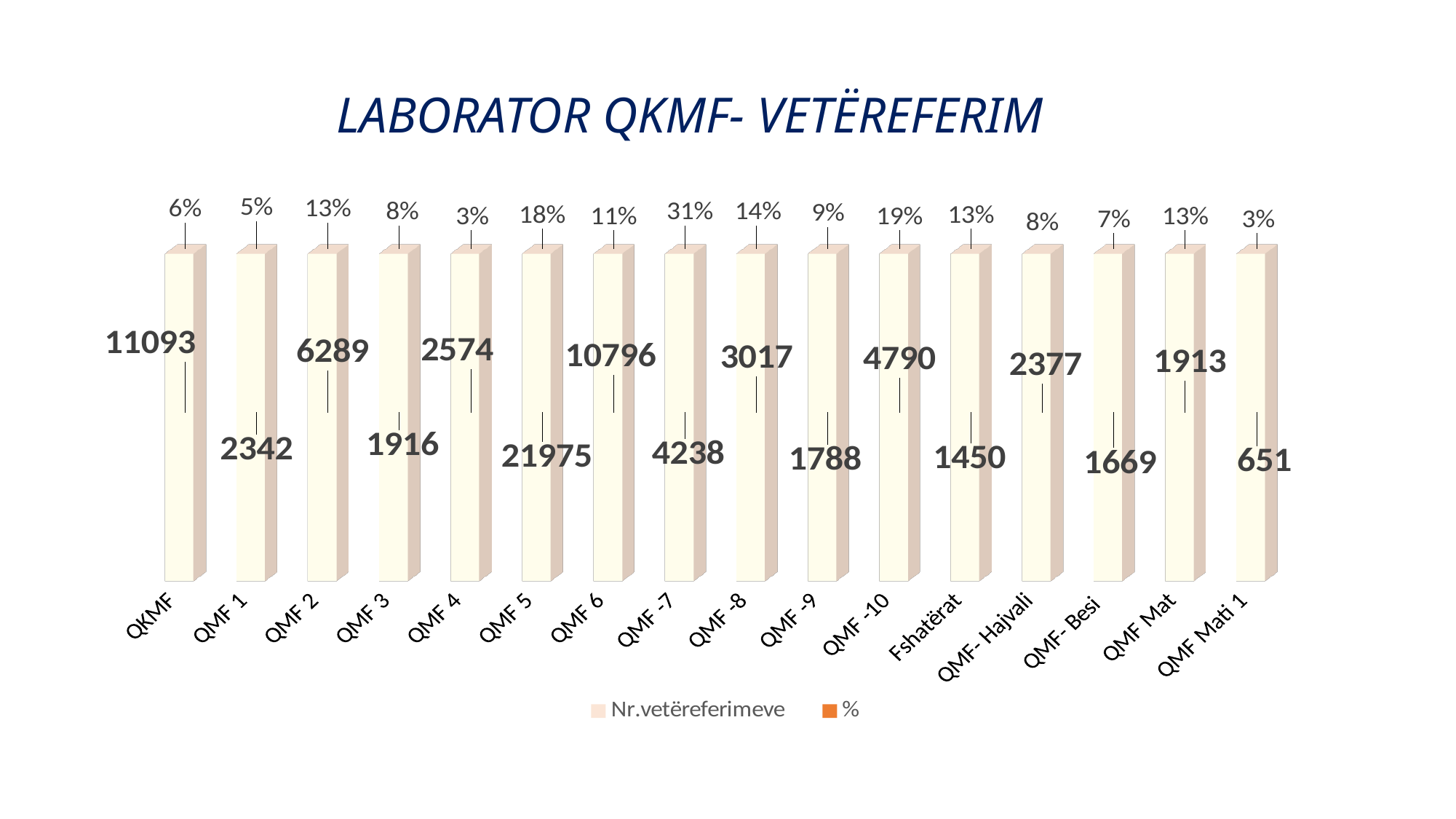
Which category has the highest percentage value? QMF -7 Which category has the highest Nr.vetëreferimeve value? QMF 5 Which category has the lowest Nr.vetëreferimeve value? QMF Mati 1 How many series does the legend list? 2 What is the Nr.vetëreferimeve value for QMF 5? 21975 What percentage is shown for QMF -10? 19% What is the Nr.vetëreferimeve value for QMF- Hajvali? 2377 What is the title of the chart? LABORATOR QKMF- VETËREFERIM How many categories are shown on the x axis? 16 Which has a larger Nr.vetëreferimeve value, QMF 2 or QMF -10? QMF 2 What percentage is shown for QMF -7? 31% What is the difference between the Nr.vetëreferimeve values for QKMF and QMF 6? 297